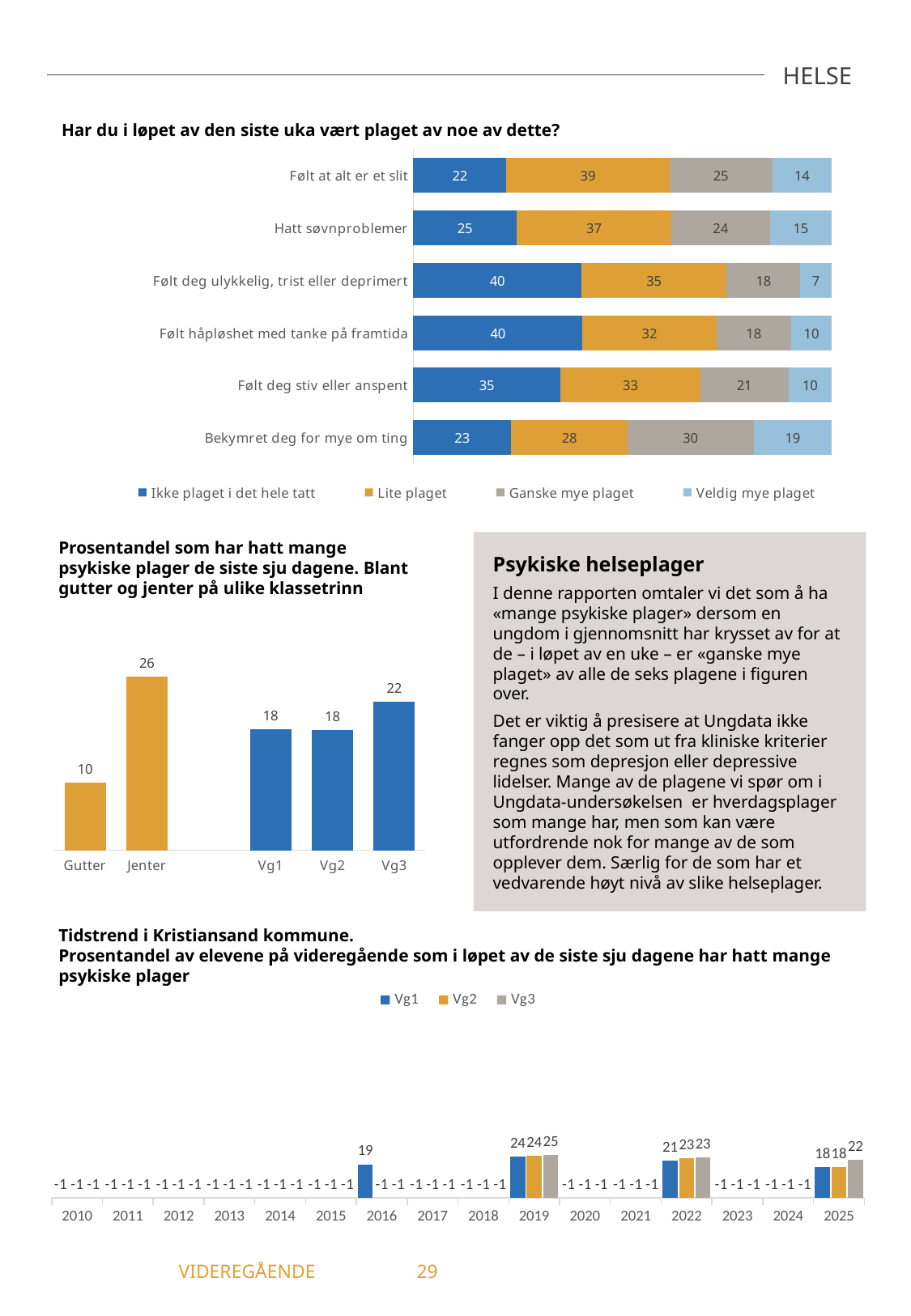
In the chart 'Prosentandel som har hatt mange psykiske plager de siste sju dagene', what is the value for Jenter? 26 In the chart 'Tidstrend i Kristiansand kommune', which is larger: Vg1 in 2019 or Vg1 in 2022? Vg1 in 2019 In the chart 'Har du i løpet av den siste uka vært plaget av noe av dette?', how many series does the legend list? 4 In the chart 'Har du i løpet av den siste uka vært plaget av noe av dette?', what is the difference between 'Ganske mye plaget' for 'Bekymret deg for mye om ting' and for 'Følt deg ulykkelig, trist eller deprimert'? 12 In the chart 'Prosentandel som har hatt mange psykiske plager de siste sju dagene', what kind of chart is it? Bar chart In the chart 'Tidstrend i Kristiansand kommune', what is the value for Vg3 in 2025? 22 In the chart 'Prosentandel som har hatt mange psykiske plager de siste sju dagene', which category has the lowest value? Gutter In the chart 'Prosentandel som har hatt mange psykiske plager de siste sju dagene', what is the difference between Jenter and Gutter? 16 In the chart 'Har du i løpet av den siste uka vært plaget av noe av dette?', which category has the highest value for 'Ikke plaget i det hele tatt'? Følt deg ulykkelig, trist eller deprimert and Følt håpløshet med tanke på framtida (both 40) In the chart 'Har du i løpet av den siste uka vært plaget av noe av dette?', how many categories are shown? 6 In the chart 'Har du i løpet av den siste uka vært plaget av noe av dette?', what is the value of 'Lite plaget' for 'Følt at alt er et slit'? 39 In the chart 'Har du i løpet av den siste uka vært plaget av noe av dette?', what is the value of 'Veldig mye plaget' for 'Bekymret deg for mye om ting'? 19